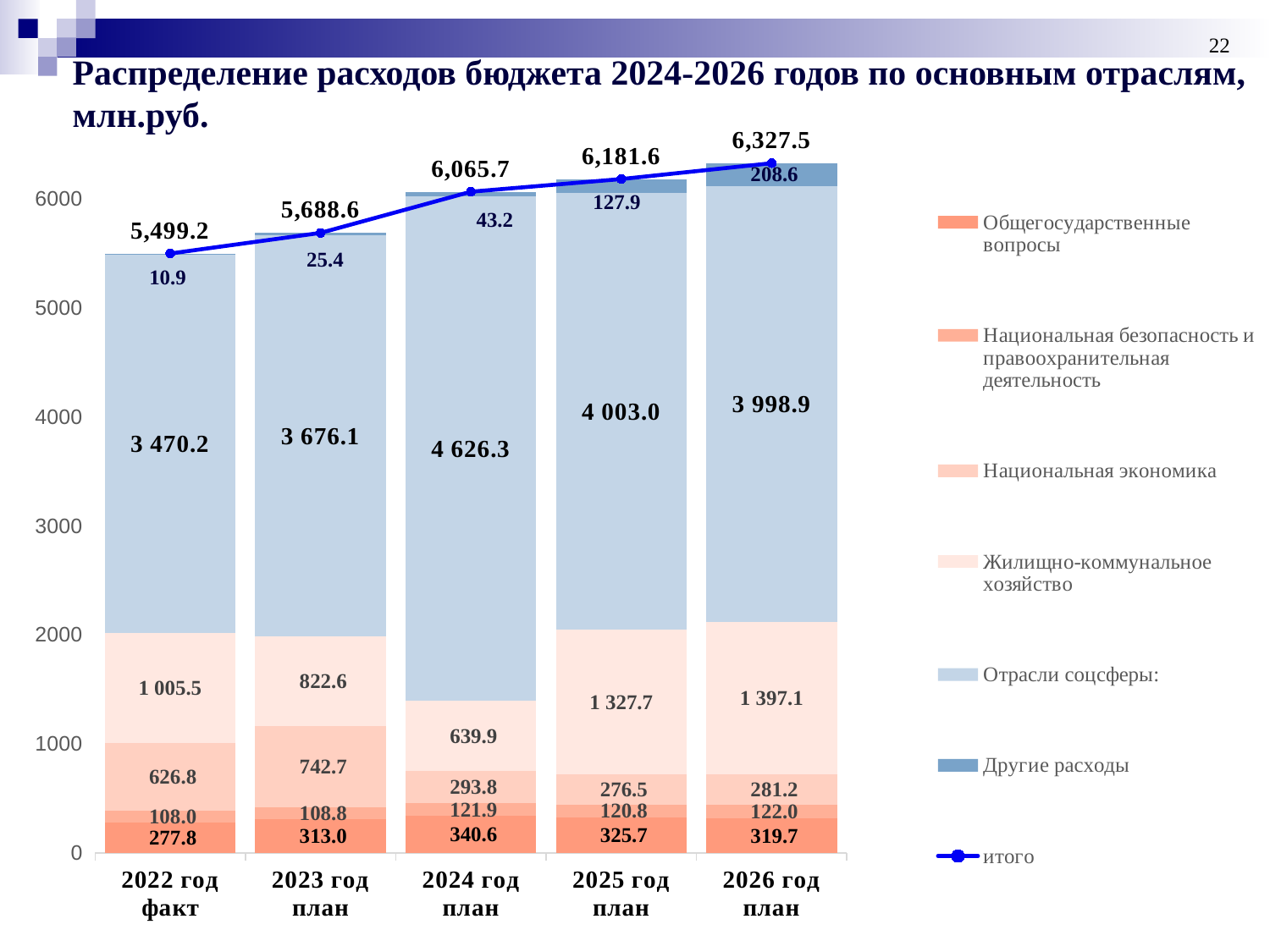
How many entries does the legend list? 7 Does the total (итого) line rise or fall from 2022 to 2026? rise Which is larger: Национальная экономика for 2023 год план or for 2024 год план? 2023 год план How many years are shown on the x axis? 5 Which year has the highest total (итого) value? 2026 год план What is the value of Другие расходы for 2026 год план? 208.6 What is the value of Жилищно-коммунальное хозяйство for 2022 год факт? 1 005.5 What is the value of Отрасли соцсферы for 2025 год план? 4 003.0 Which year has the lowest value for Другие расходы? 2022 год факт What is the total (итого) value for 2024 год план? 6,065.7 Is the total (итого) for 2023 год план greater or less than 6000? less What is the difference between the total (итого) for 2026 год план and 2025 год план? 145.9